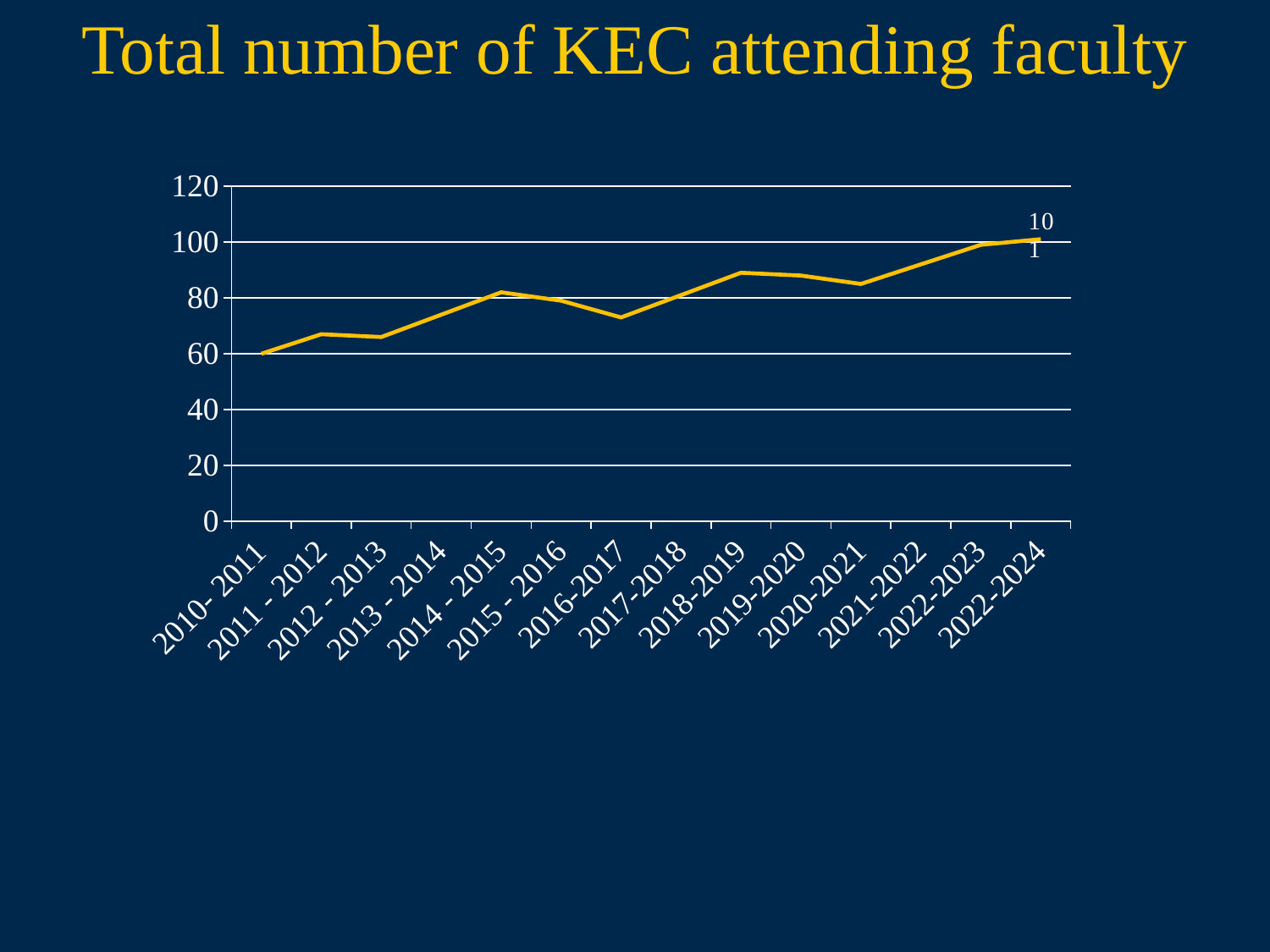
Which is larger, the value for 2018-2019 or the value for 2016-2017? 2018-2019 What is the value labelled for 2022-2024? 101 Is the value for 2018-2019 greater or less than 80? greater How many academic-year categories are shown on the x axis? 14 Overall, do the values rise or fall from 2010-2011 to 2022-2024? rise Is the value for 2011-2012 greater or less than 60? greater Which academic year has the highest number of KEC attending faculty? 2022-2024 Which academic year has the lowest number of KEC attending faculty? 2010-2011 What kind of chart is shown on the slide? line chart Is the value for 2010-2011 greater or less than 80? less What is the title of the chart? Total number of KEC attending faculty